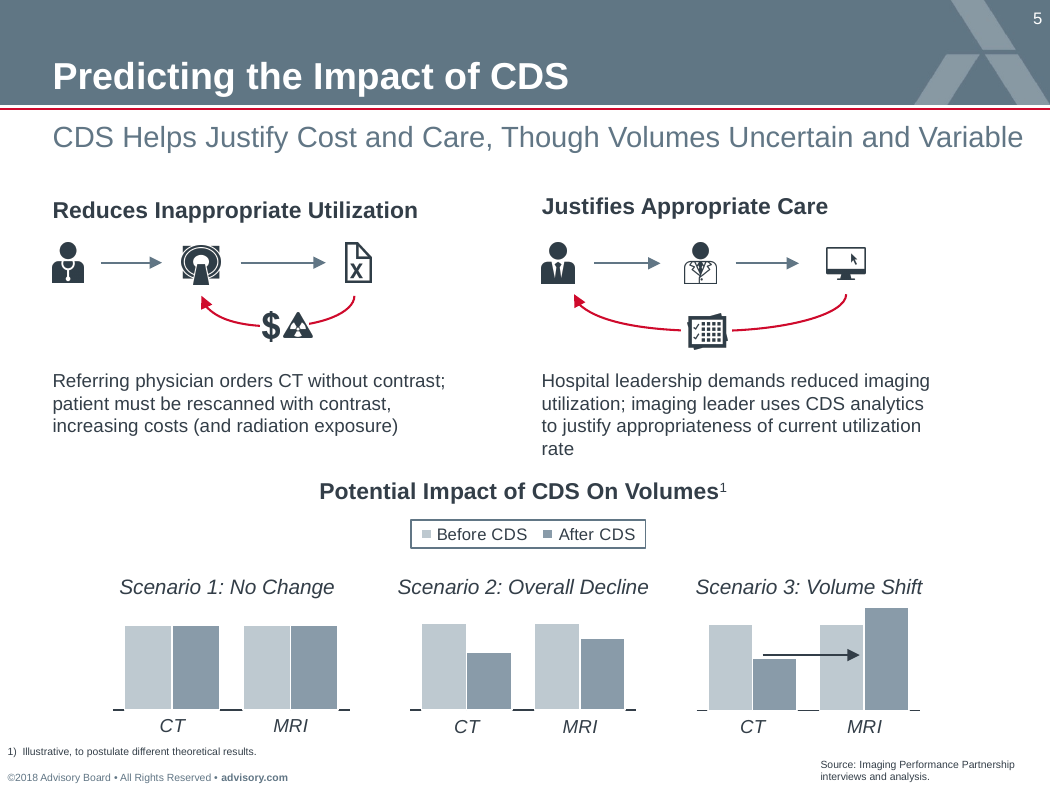
How many separate scenario bar charts are shown under "Potential Impact of CDS On Volumes"? 3 What is the title of the leftmost of the three bar charts on the slide? Scenario 1: No Change In the Scenario 3: Volume Shift chart, which is larger for CT, Before CDS or After CDS? Before CDS How many series does the legend for the "Potential Impact of CDS On Volumes" charts list? 2 What are the two series named in the legend of the "Potential Impact of CDS On Volumes" charts? Before CDS and After CDS In the Scenario 3: Volume Shift chart, which bar is the shortest? CT After CDS What kind of chart is used for the three scenarios under "Potential Impact of CDS On Volumes"? Bar chart In the Scenario 3: Volume Shift chart, which bar is the tallest? MRI After CDS In the Scenario 2: Overall Decline chart, how many categories are shown on the x axis? 2 In the Scenario 2: Overall Decline chart, which is larger for MRI, Before CDS or After CDS? Before CDS In the Scenario 2: Overall Decline chart, which is larger for CT, Before CDS or After CDS? Before CDS